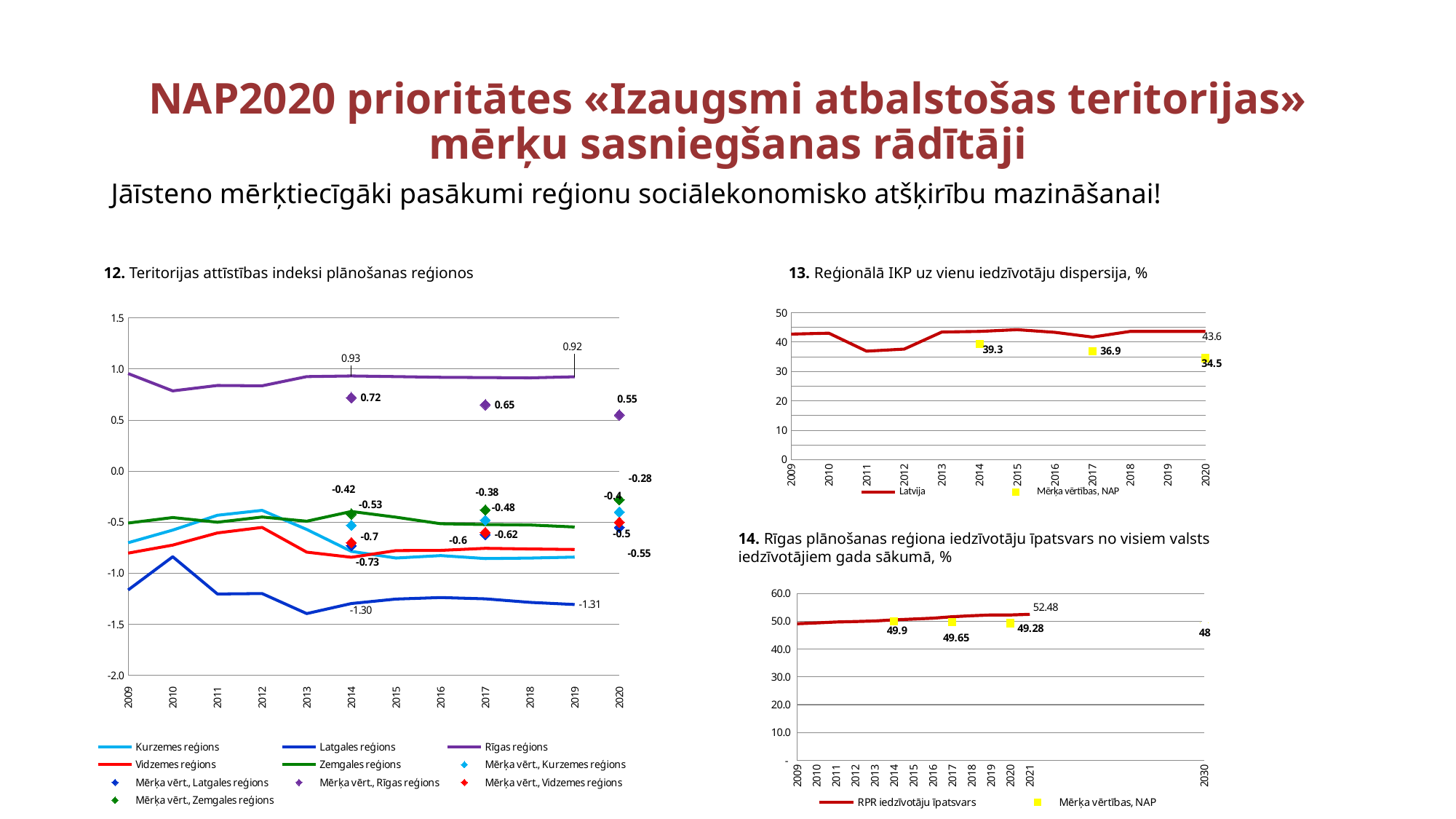
In chart 13 (Reģionālā IKP uz vienu iedzīvotāju dispersija, %), is the Latvija value for 2011 greater or less than 40? less In chart 12 (Teritorijas attīstības indeksi plānošanas reģionos), what is the target value (Mērķa vērt.) for Rīgas reģions in 2020? 0.55 In chart 14 (Rīgas plānošanas reģiona iedzīvotāju īpatsvars), which is larger: the NAP target for 2014 or the NAP target for 2030? 2014 (49.9) In chart 12 (Teritorijas attīstības indeksi plānošanas reģionos), which region's line is the lowest across the whole period? Latgales reģions In chart 12 (Teritorijas attīstības indeksi plānošanas reģionos), what is the labelled value for Latgales reģions in 2019? -1.31 In chart 13 (Reģionālā IKP uz vienu iedzīvotāju dispersija, %), what is the NAP target value for 2017? 36.9 What kind of chart is chart 13 (Reģionālā IKP uz vienu iedzīvotāju dispersija, %)? Line chart In chart 12 (Teritorijas attīstības indeksi plānošanas reģionos), how many entries does the legend list? 10 In chart 12 (Teritorijas attīstības indeksi plānošanas reģionos), what is the labelled value for Rīgas reģions in 2014? 0.93 In chart 13 (Reģionālā IKP uz vienu iedzīvotāju dispersija, %), what is the labelled value for Latvija in 2020? 43.6 In chart 14 (Rīgas plānošanas reģiona iedzīvotāju īpatsvars), what is the labelled value of RPR iedzīvotāju īpatsvars in 2021? 52.48 In chart 12 (Teritorijas attīstības indeksi plānošanas reģionos), what is the difference between the Rīgas reģions target values for 2014 (0.72) and 2020 (0.55)? 0.17